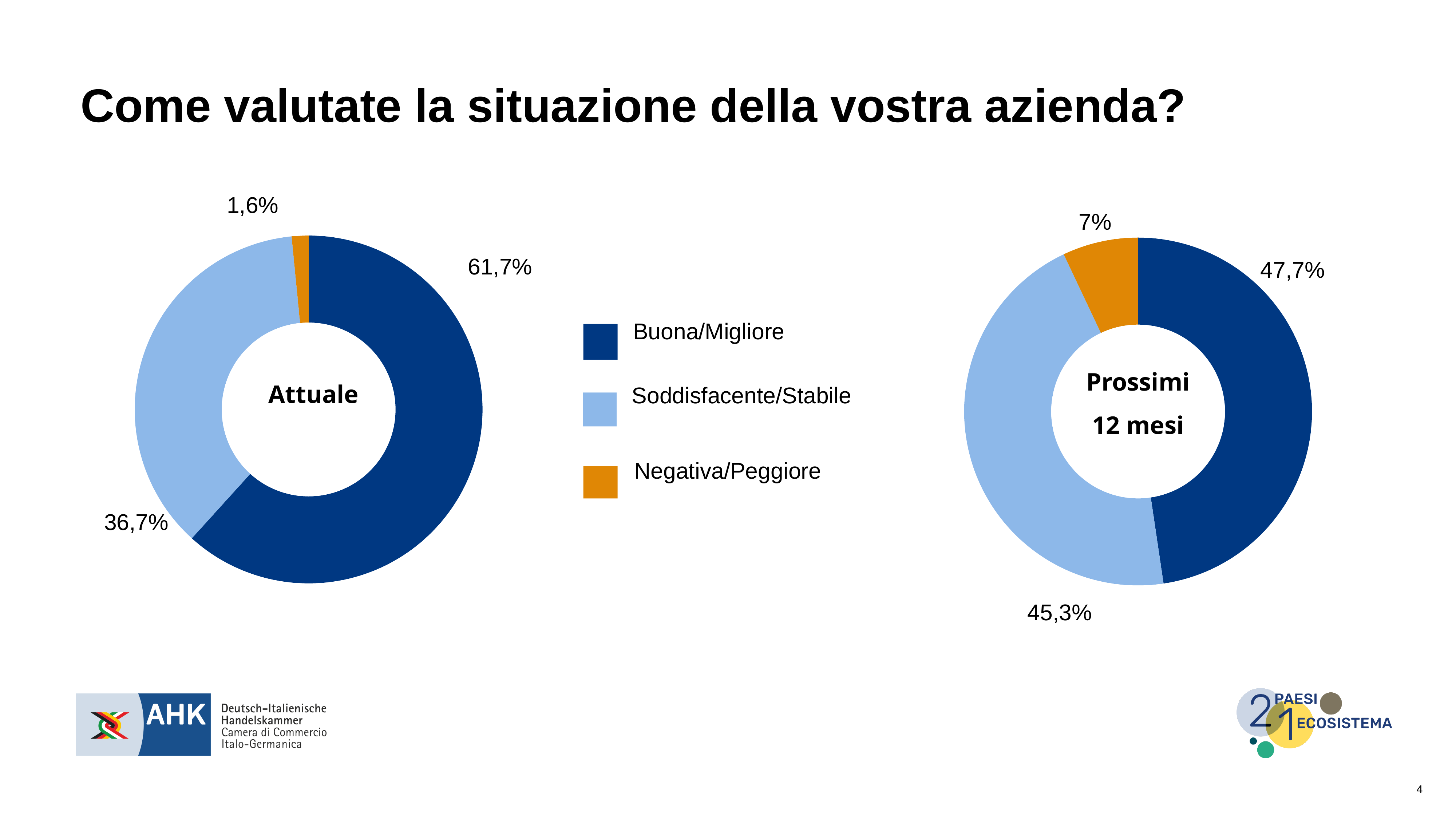
In the 'Attuale' chart, what is the value for Soddisfacente/Stabile? 36,7% What kind of chart is the 'Attuale' chart? Pie (donut) chart In the 'Prossimi 12 mesi' chart, what is the difference between Buona/Migliore and Soddisfacente/Stabile? 2,4% In the 'Attuale' chart, what is the value for Buona/Migliore? 61,7% How many categories does the legend list? 3 In the 'Prossimi 12 mesi' chart, which category has the smallest share? Negativa/Peggiore In the 'Attuale' chart, what is the value for Negativa/Peggiore? 1,6% In the 'Prossimi 12 mesi' chart, what is the value for Negativa/Peggiore? 7% In the 'Attuale' chart, what is the difference between Buona/Migliore and Soddisfacente/Stabile? 25% In the 'Attuale' chart, which category has the largest share? Buona/Migliore Which is larger: Soddisfacente/Stabile in the 'Attuale' chart or Soddisfacente/Stabile in the 'Prossimi 12 mesi' chart? Prossimi 12 mesi In the 'Prossimi 12 mesi' chart, what is the value for Buona/Migliore? 47,7%